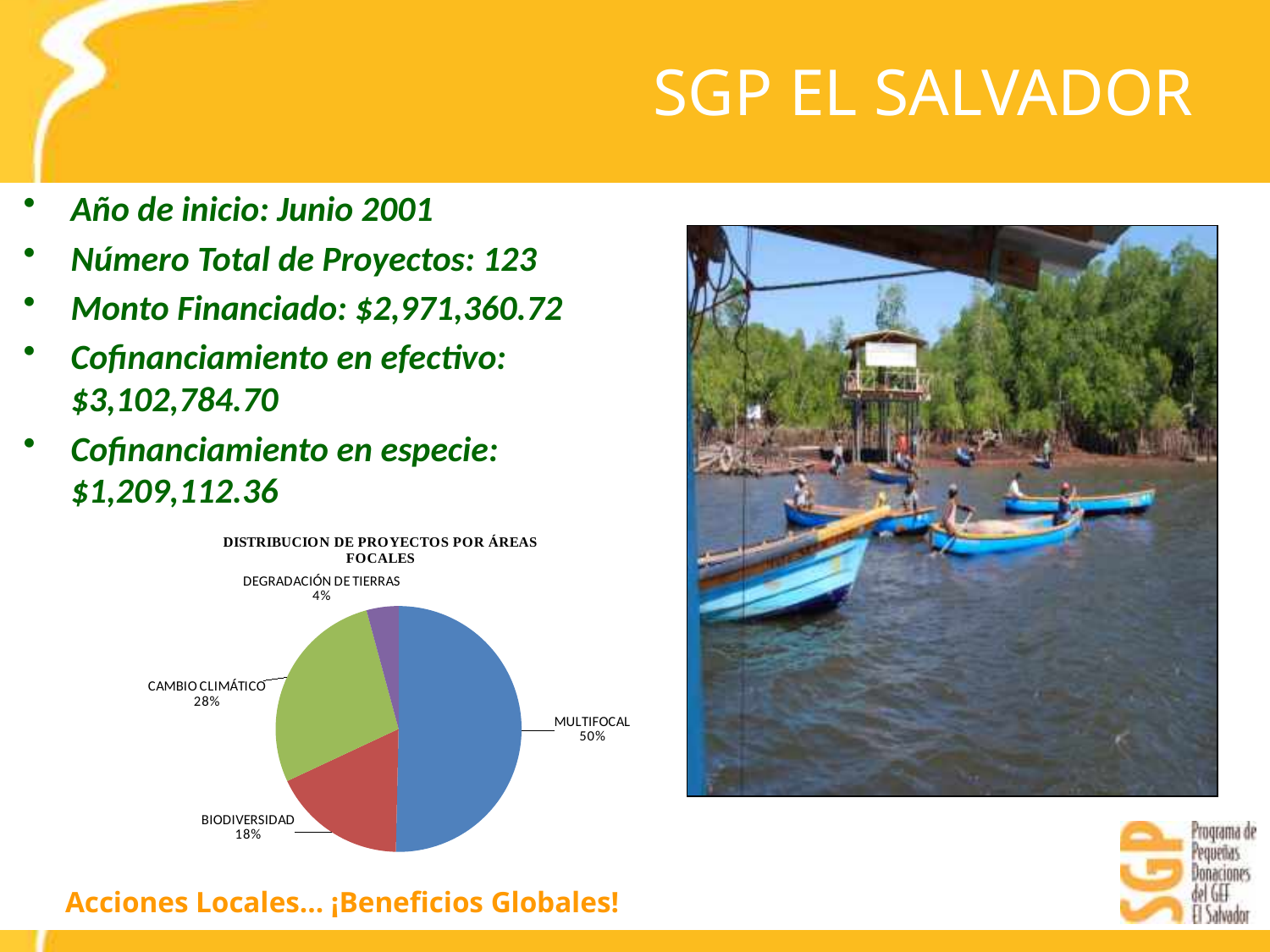
What share of projects is DEGRADACIÓN DE TIERRAS? 4% Which focal area has the largest share of projects? MULTIFOCAL How many focal areas are shown in the pie chart? 4 What share of projects is MULTIFOCAL? 50% What is the title of the chart? DISTRIBUCION DE PROYECTOS POR ÁREAS FOCALES What share of projects is CAMBIO CLIMÁTICO? 28% What is the difference in percentage points between MULTIFOCAL and CAMBIO CLIMÁTICO? 22% Which has a larger share, CAMBIO CLIMÁTICO or BIODIVERSIDAD? CAMBIO CLIMÁTICO What kind of chart is shown on the slide? pie chart What is the difference in percentage points between BIODIVERSIDAD and DEGRADACIÓN DE TIERRAS? 14% Which focal area has the smallest share of projects? DEGRADACIÓN DE TIERRAS